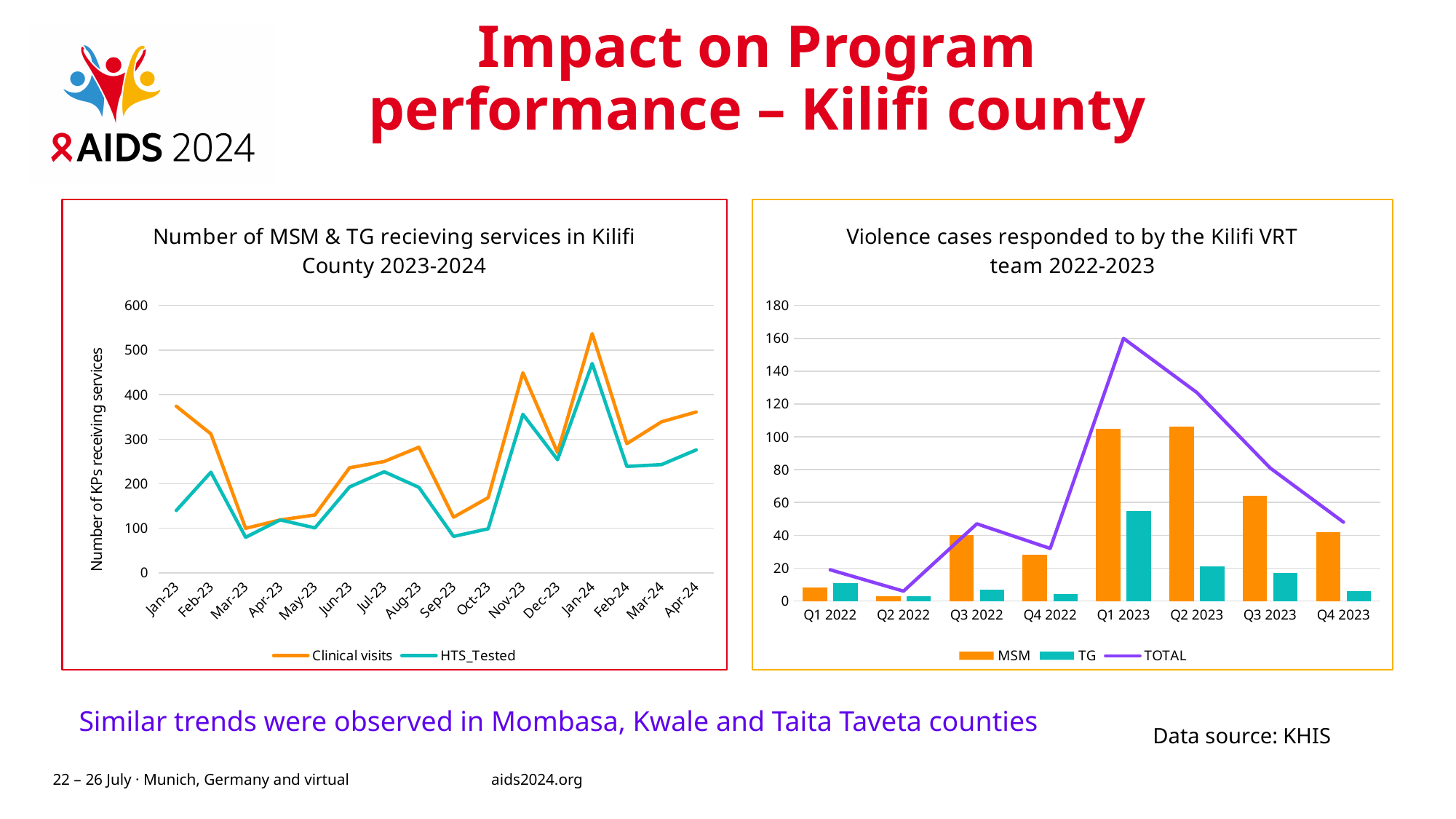
In the left chart, in which month do Clinical visits reach their highest value? Jan-24 How many series does the legend of the left chart list? 2 In the right chart, is the TOTAL value for Q1 2023 greater or less than 140? greater In the left chart, which series has the larger value in Jan-23, Clinical visits or HTS_Tested? Clinical visits In the left chart, is the value for HTS_Tested in Mar-23 greater or less than 100? less What kind of chart is the left chart, 'Number of MSM & TG recieving services in Kilifi County 2023-2024'? Line chart How many series does the legend of the right chart, 'Violence cases responded to by the Kilifi VRT team 2022-2023', list? 3 How many months are shown on the x axis of the left chart? 16 In the right chart, in which quarter does the TOTAL line reach its highest value? Q1 2023 In the left chart, in which month do Clinical visits reach their lowest value? Mar-23 In the left chart, is the value for Clinical visits in Jan-24 greater or less than 500? greater How many quarters are shown on the x axis of the right chart? 8